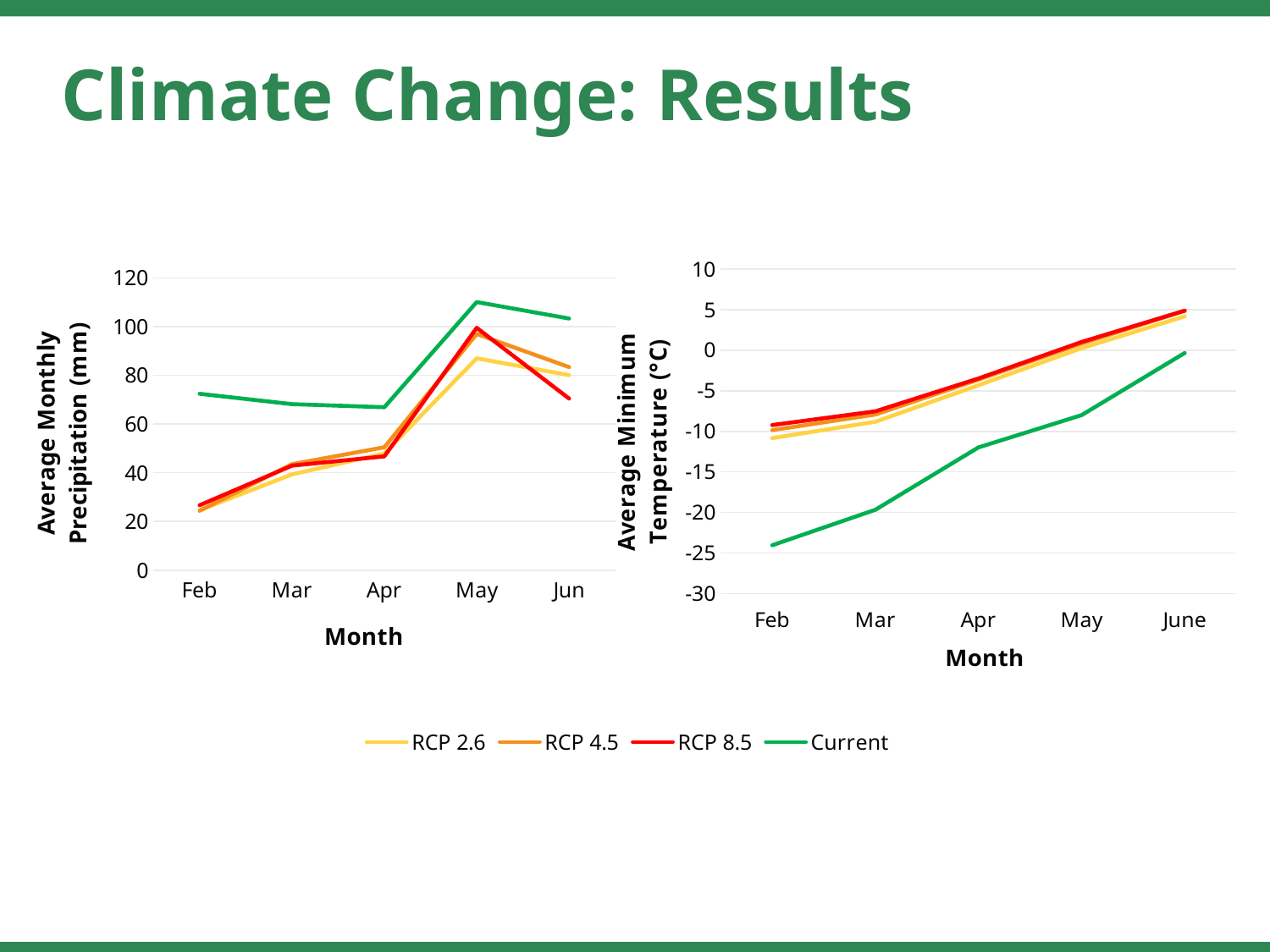
In the right chart (Average Minimum Temperature), is the Current value for Feb greater or less than -20? less In the left chart (Average Monthly Precipitation), is the RCP 8.5 value for Jun greater or less than 80? less In the right chart (Average Minimum Temperature), is the RCP 8.5 value for June greater or less than 0? greater In the right chart (Average Minimum Temperature), which month has the lowest value for the Current series? Feb In the left chart (Average Monthly Precipitation), which series has the highest value in Feb? Current In the left chart (Average Monthly Precipitation), how many months are shown on the x axis? 5 In the left chart (Average Monthly Precipitation), which month has the highest value for the Current series? May How many series does the legend list? 4 In the right chart (Average Minimum Temperature), which is larger in Feb: the Current value or the RCP 8.5 value? RCP 8.5 In the right chart (Average Minimum Temperature), do the values for the Current series rise or fall from Feb to June? rise What type of chart is the left chart (Average Monthly Precipitation)? line chart